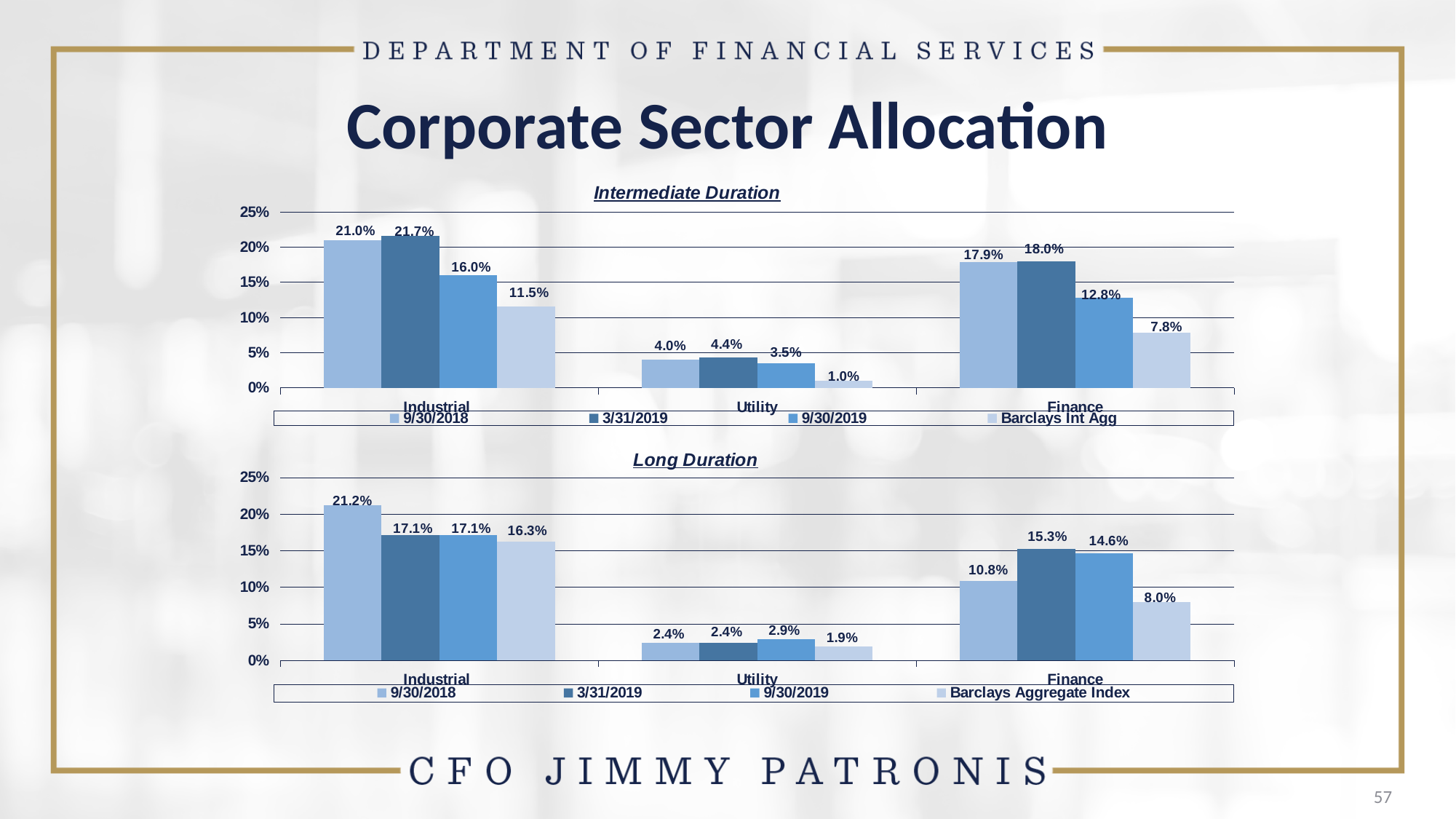
In the Intermediate Duration chart, what is the Barclays Int Agg value for Utility? 1.0% In the Intermediate Duration chart, what is the difference between the 9/30/2019 value for Industrial and the Barclays Int Agg value for Industrial? 4.5% In the Long Duration chart, what is the value for Finance in the 9/30/2019 series? 14.6% In the Intermediate Duration chart, which is larger for Finance: the 9/30/2018 value or the 9/30/2019 value? 9/30/2018 In the Intermediate Duration chart, what is the value for Industrial in the 3/31/2019 series? 21.7% How many series does the legend of the Long Duration chart list? 4 In the Intermediate Duration chart, which category has the lowest 9/30/2019 value? Utility How many categories are shown on the x axis of the Intermediate Duration chart? 3 In the Long Duration chart, which category has the highest Barclays Aggregate Index value? Industrial What kind of chart is the Long Duration chart? Bar chart In the Long Duration chart, what is the 9/30/2018 value for Industrial? 21.2% In the Long Duration chart, what is the difference between the 3/31/2019 and 9/30/2018 values for Finance? 4.5%